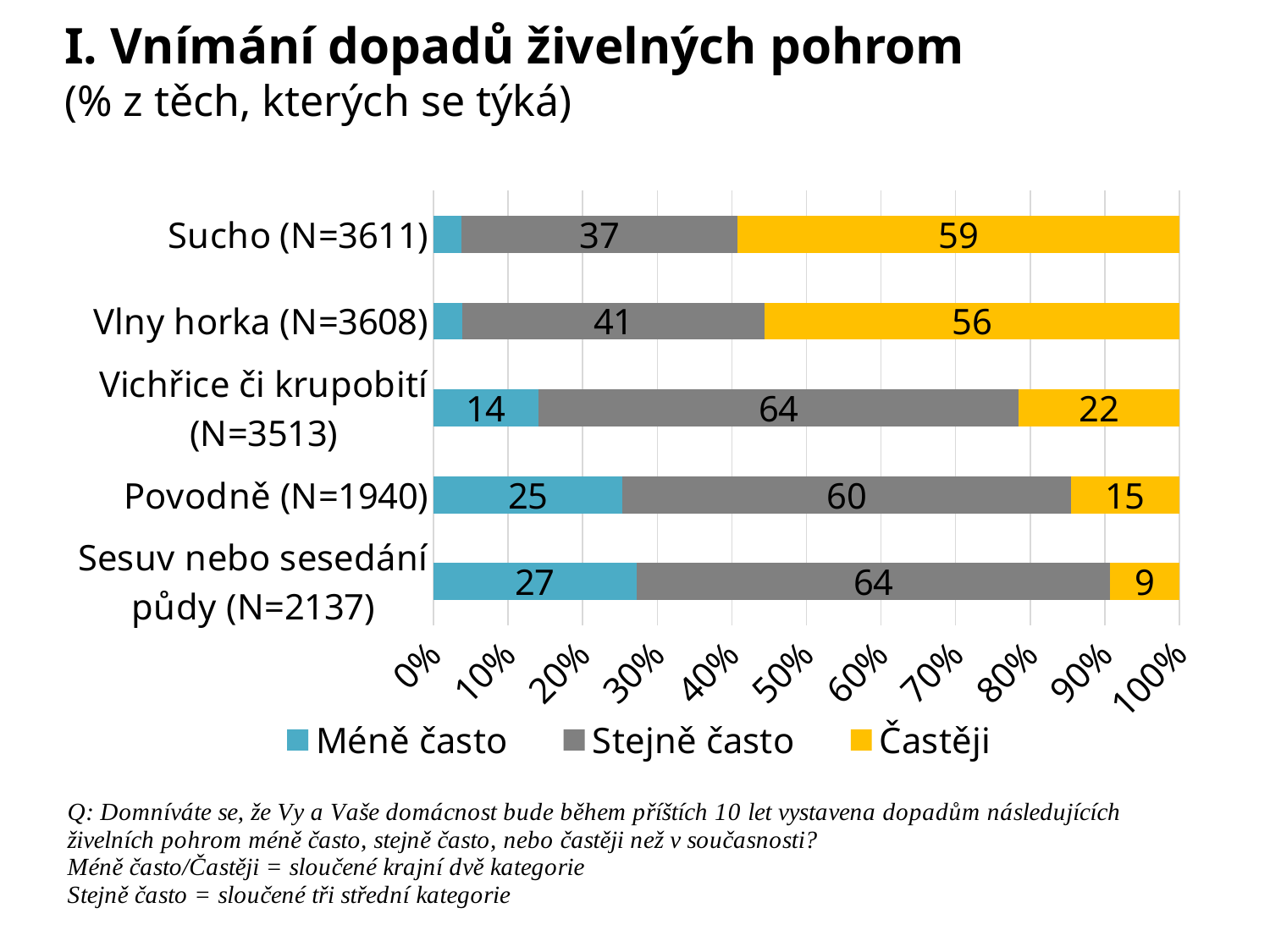
What is the value of 'Častěji' for Sucho (N=3611)? 59 Which category has the highest 'Častěji' value? Sucho (N=3611) Is the 'Méně často' value for Sucho (N=3611) greater or less than 10%? less Which category has the lowest 'Častěji' value? Sesuv nebo sesedání půdy (N=2137) How many categories (types of disaster) are shown on the chart? 5 What type of chart is shown on the slide? stacked bar chart Which is larger: the 'Méně často' value for Vichřice či krupobití (N=3513) or for Sesuv nebo sesedání půdy (N=2137)? Sesuv nebo sesedání půdy (N=2137) Which legend entry is shown in yellow? Častěji How many series does the legend list? 3 What is the difference between the 'Častěji' values for Sucho (N=3611) and Povodně (N=1940)? 44 What is the value of 'Stejně často' for Vlny horka (N=3608)? 41 What is the value of 'Méně často' for Povodně (N=1940)? 25